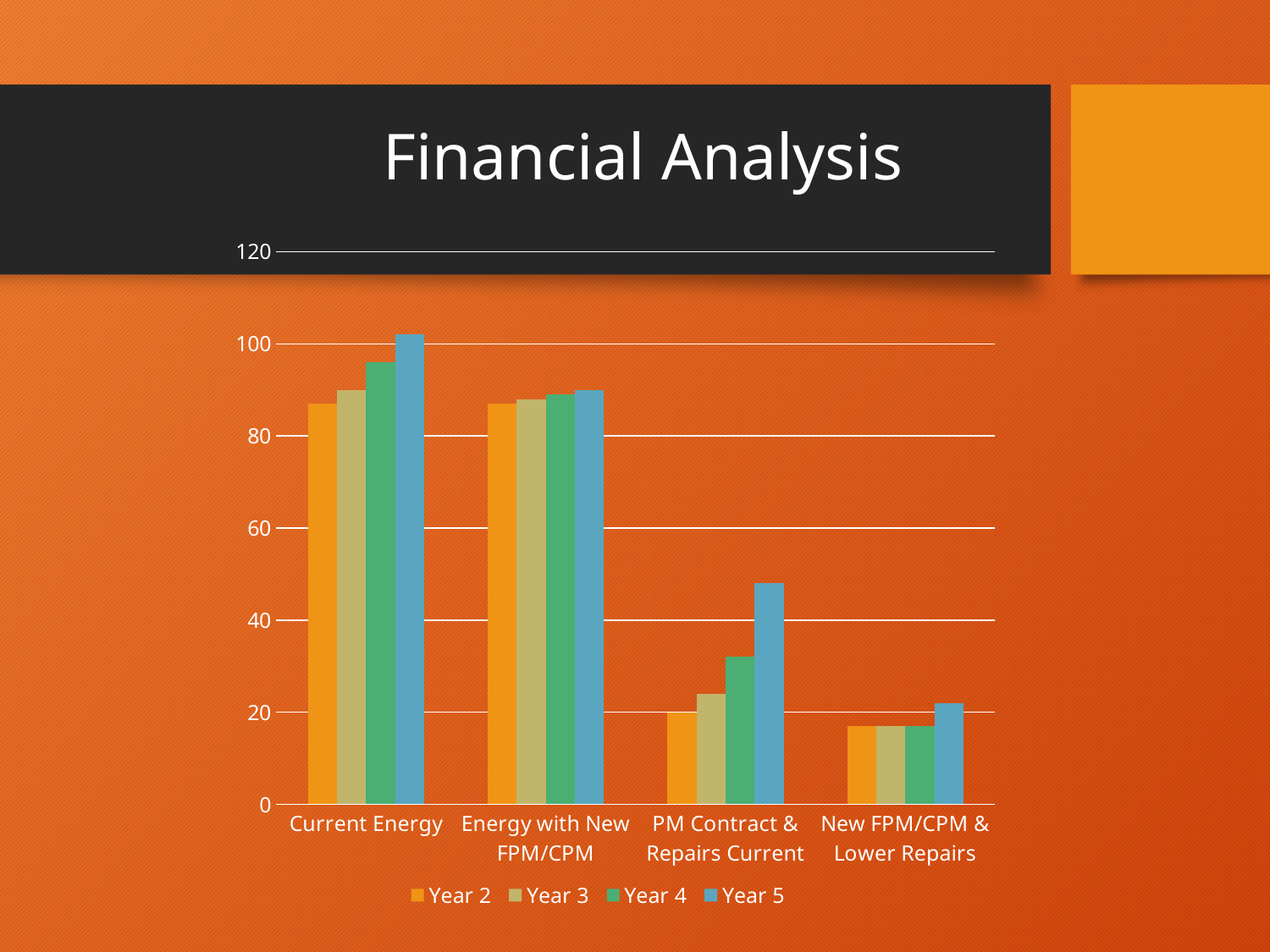
What is the title of the slide containing the chart? Financial Analysis Which series is listed first in the chart's legend? Year 2 Which category has the lowest Year 5 value? New FPM/CPM & Lower Repairs Which category has the highest Year 5 value? Current Energy Which is larger: the Year 5 value for Current Energy or the Year 5 value for Energy with New FPM/CPM? Current Energy What kind of chart is shown on the slide? bar chart Is the Year 2 value for New FPM/CPM & Lower Repairs greater or less than 20? less How many categories are shown on the x axis of the chart? 4 How many series does the chart's legend list? 4 Is the Year 2 value for Current Energy greater or less than 80? greater Is the Year 4 value for PM Contract & Repairs Current greater or less than 40? less